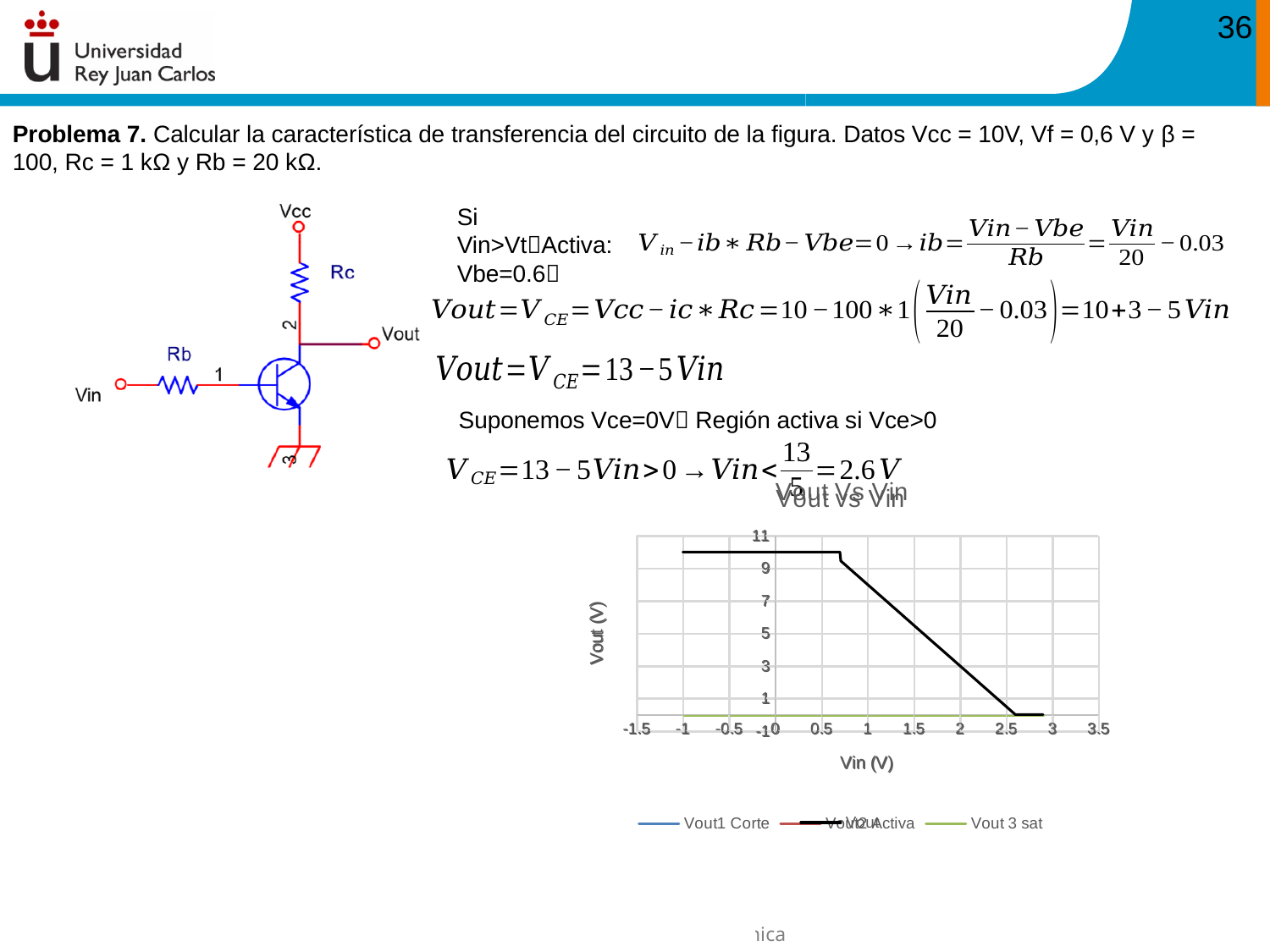
Which is larger, Vout at Vin = 0.5 or Vout at Vin = 2? Vout at Vin = 0.5 Is the value of Vout at Vin = 1 greater or less than 5? greater What is the title of the chart? Vout Vs Vin What is the label of the x axis of the chart? Vin (V) Is the value of Vout at Vin = -0.5 greater or less than 9? greater Is the value of Vout at Vin = 2 greater or less than 5? less Between Vin = 1 and Vin = 2.5, does Vout rise or fall? fall What is the highest tick value shown on the x axis of the chart? 3.5 How many series does the legend of the chart list? 3 What kind of chart is shown on the slide? line chart